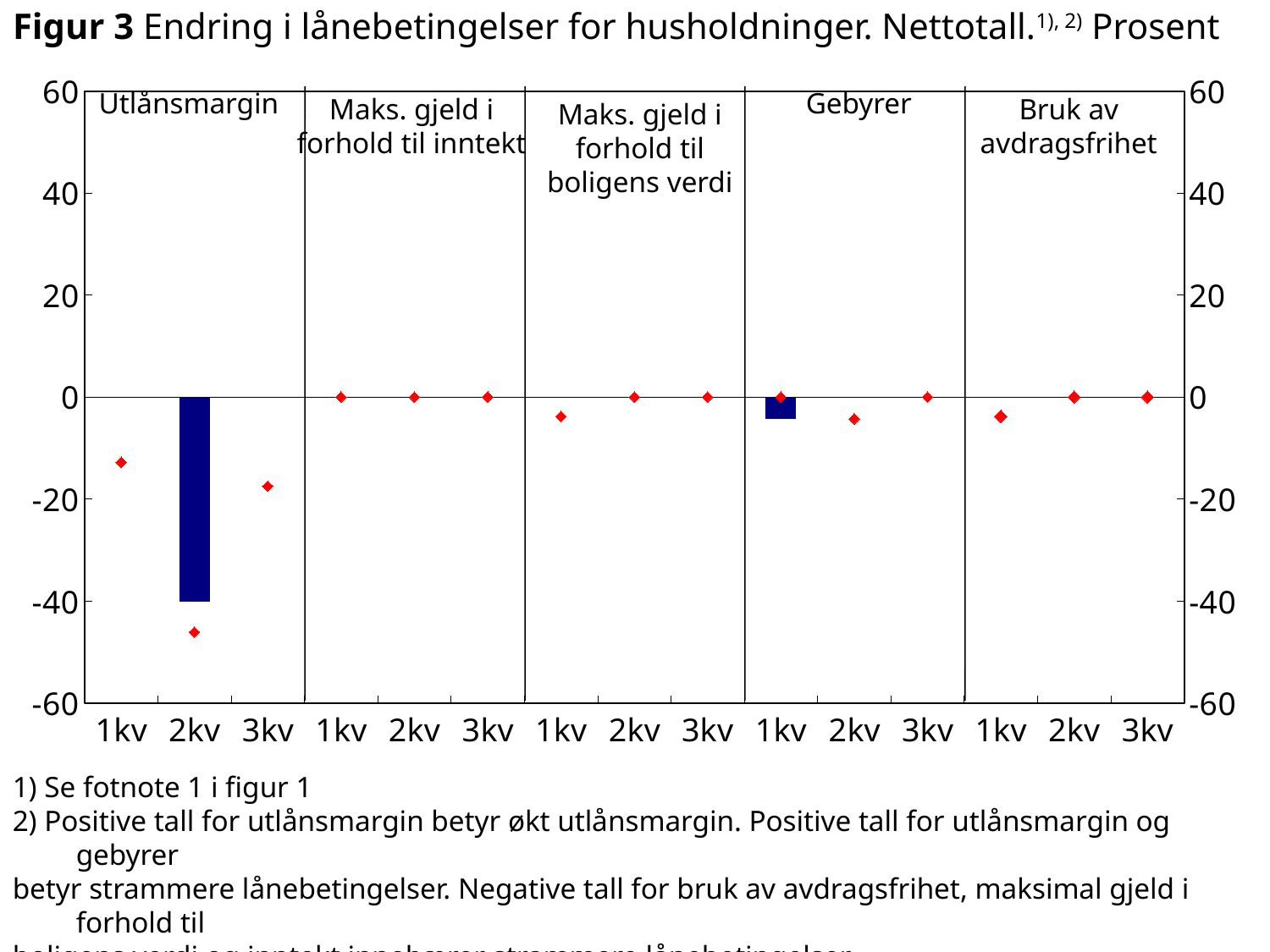
What kind of chart is shown in Figur 3? bar chart What is the value of the red marker for 2kv in the 'Maks. gjeld i forhold til inntekt' panel? 0 How many panels (loan condition categories) does the chart have? 5 What is the maximum value shown on the y axis? 60 What is the title of the chart? Figur 3 Endring i lånebetingelser for husholdninger. Nettotall. Prosent Is the red marker for 2kv in the Utlånsmargin panel greater or less than -40? less How many quarters are shown on the x axis within each panel? 3 In the Utlånsmargin panel, which red marker is lower: 2kv or 3kv? 2kv Is the bar for 1kv in the Gebyrer panel greater or less than -20? greater Is the red marker for 1kv in the Utlånsmargin panel greater or less than -20? greater In which panel does the tallest bar appear? Utlånsmargin